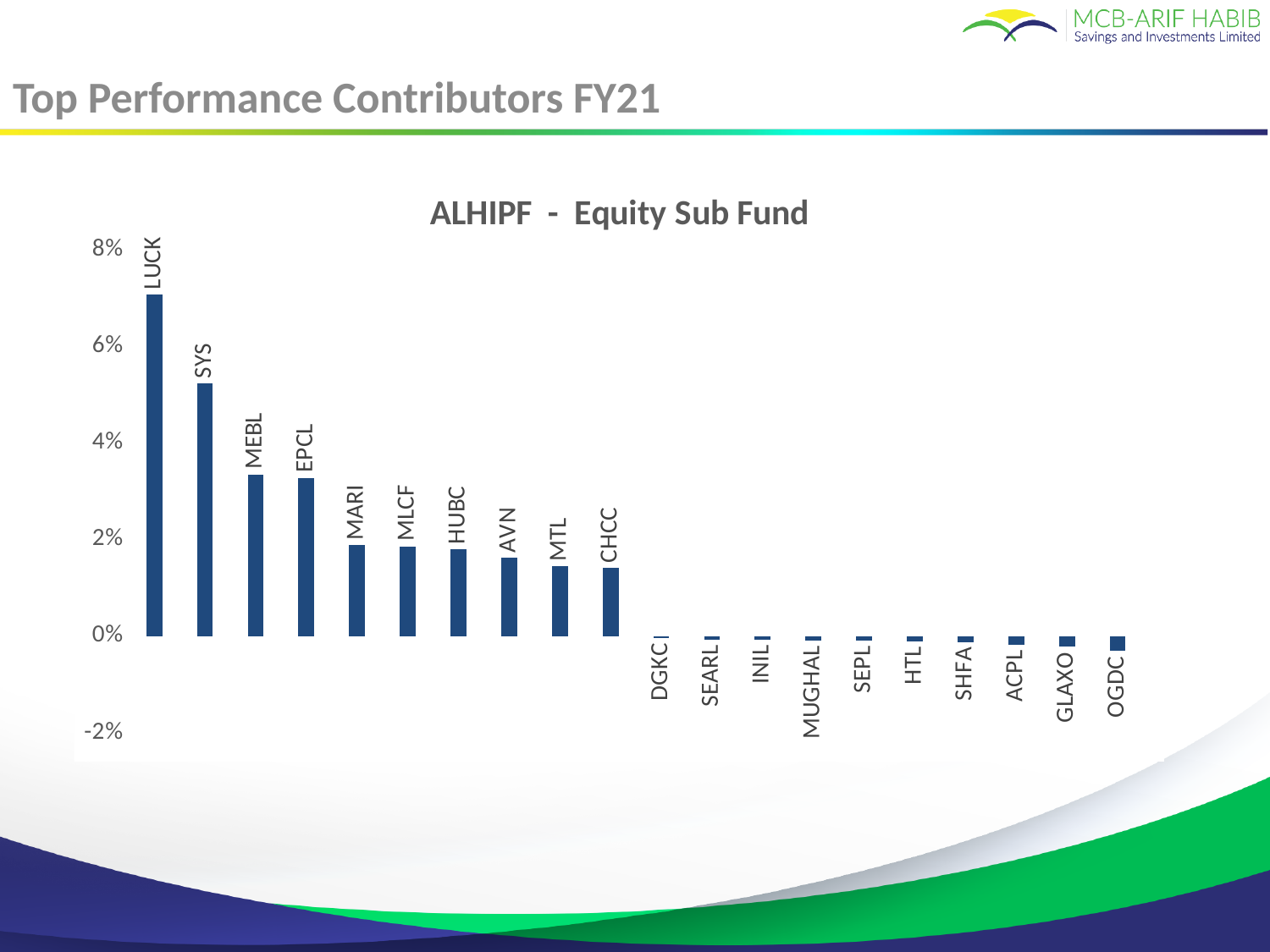
How many categories are plotted on the chart? 20 Which category has the highest value? LUCK Do the values rise or fall moving from left to right along the x axis? fall Which is larger, the value for LUCK or the value for SYS? LUCK Is the value for LUCK greater or less than 6%? greater Is the value for MEBL greater or less than 4%? less What is the title of the chart? ALHIPF - Equity Sub Fund Is the value for SYS greater or less than 4%? greater What kind of chart is shown on the slide? Bar chart How many categories have a negative value? 10 Which is larger, the value for EPCL or the value for HUBC? EPCL